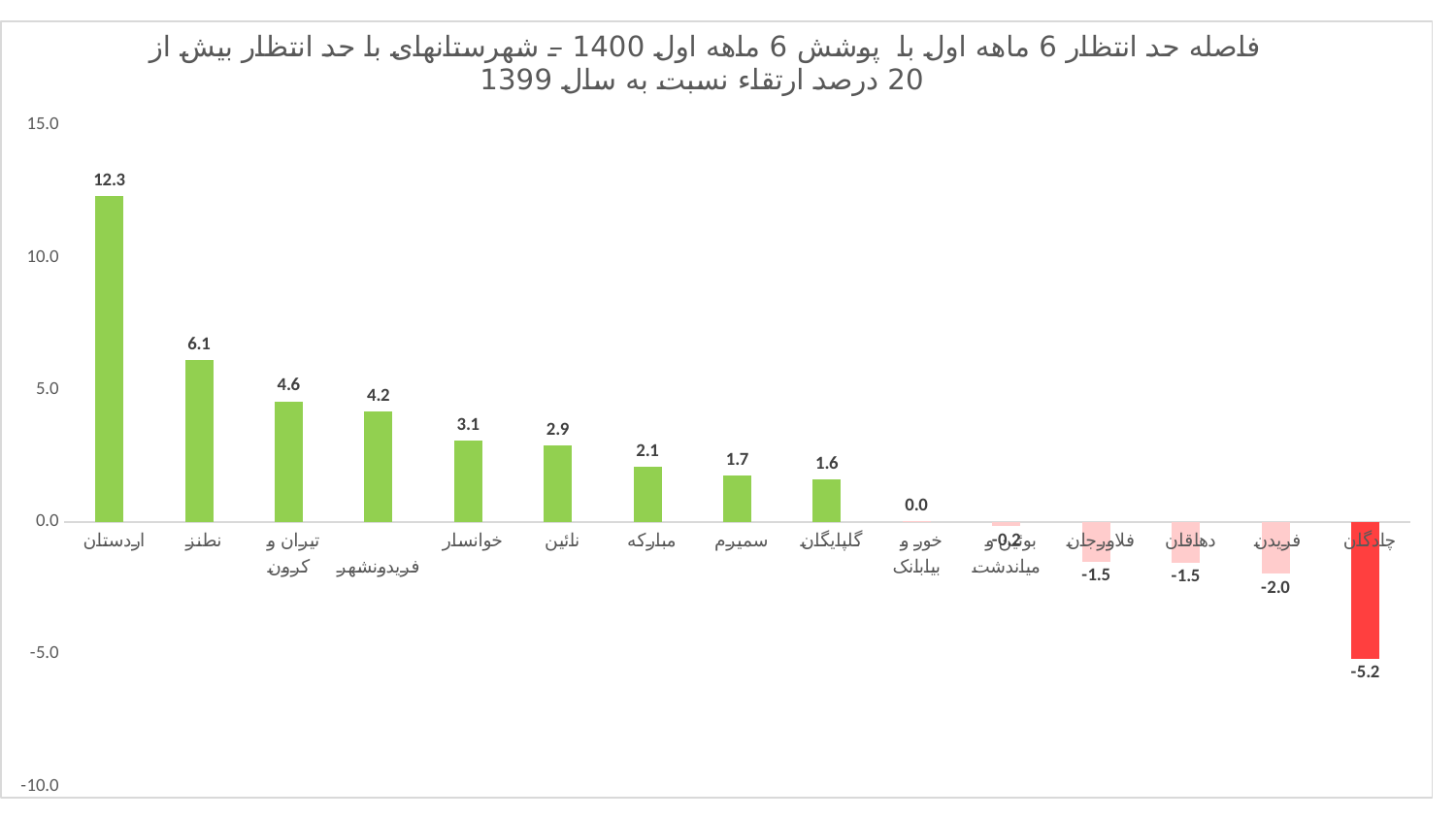
Which category has the lowest value? چادگان What colour are the bars with negative values? red What is the value for نطنز? 6.1 Which category has the highest value? اردستان Do the values rise or fall moving from left to right along the x axis? fall What is the difference between the values for اردستان and نطنز? 6.2 Which is larger, the value for تیران و کرون or the value for فریدونشهر? تیران و کرون What type of chart is shown on the slide? bar chart What is the value for چادگان? -5.2 How many categories are plotted in the chart? 15 What is the value for خوانسار? 3.1 What is the value for اردستان? 12.3